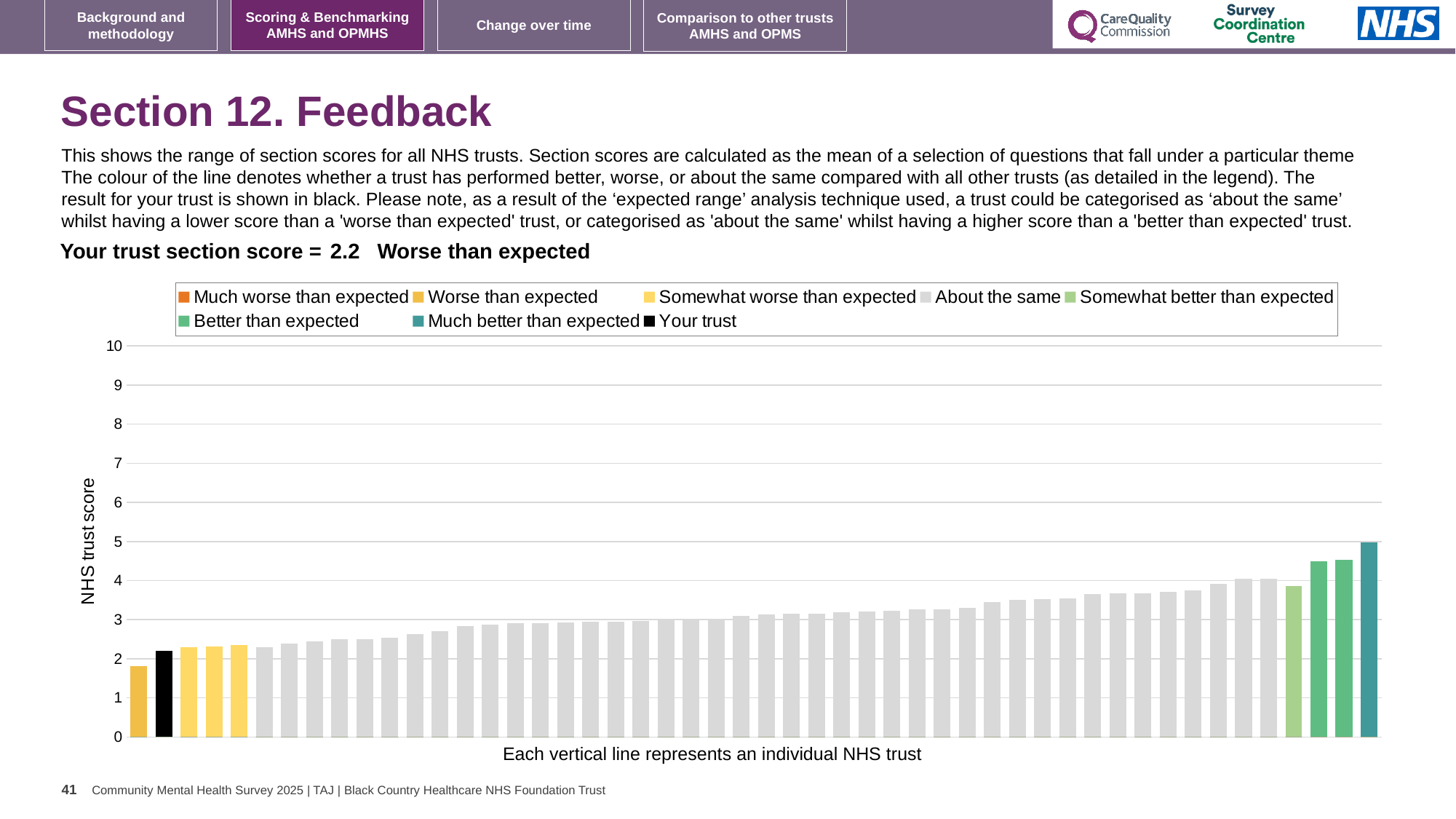
Which category is your trust's section score placed in? Worse than expected Is the value of the tallest bar greater or less than 4? greater What is the section score for your trust shown on the slide? 2.2 What kind of chart is shown on the slide? bar chart Is the value of the leftmost bar greater or less than 2? less Which legend category does the tallest bar belong to? Much better than expected What is the label on the y axis of the chart? NHS trust score Do the bar values rise or fall from left to right along the x axis? rise How many bars are coloured as 'Better than expected'? 2 How many entries does the chart legend list? 8 Which is larger: the black 'Your trust' bar or the leftmost bar? the black 'Your trust' bar What is the highest value shown on the y axis? 10